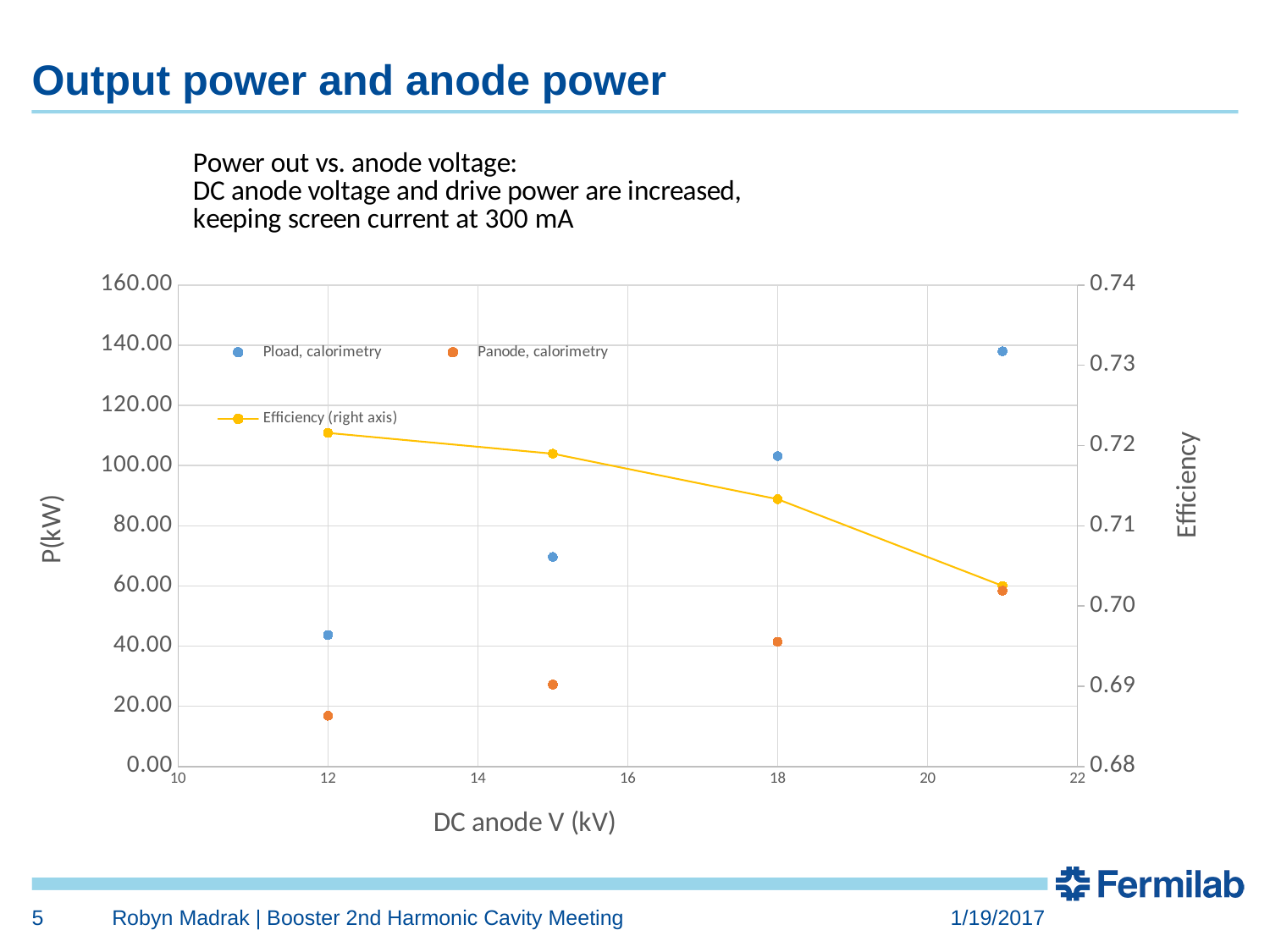
At which DC anode voltage is Pload, calorimetry highest? 21 kV Does Pload, calorimetry rise or fall as DC anode voltage increases? rise Is the Pload, calorimetry value at 21 kV greater or less than 120? greater How many data points are plotted for the Pload, calorimetry series? 4 Is the Panode, calorimetry value at 12 kV greater or less than 20? less Is the Efficiency value at 21 kV greater or less than 0.71? less What kind of chart is shown on the slide? scatter chart Does Efficiency rise or fall as DC anode voltage increases? fall How many series does the chart's legend list? 3 What is the title of the x axis? DC anode V (kV) At 18 kV, which is larger: Pload, calorimetry or Panode, calorimetry? Pload, calorimetry